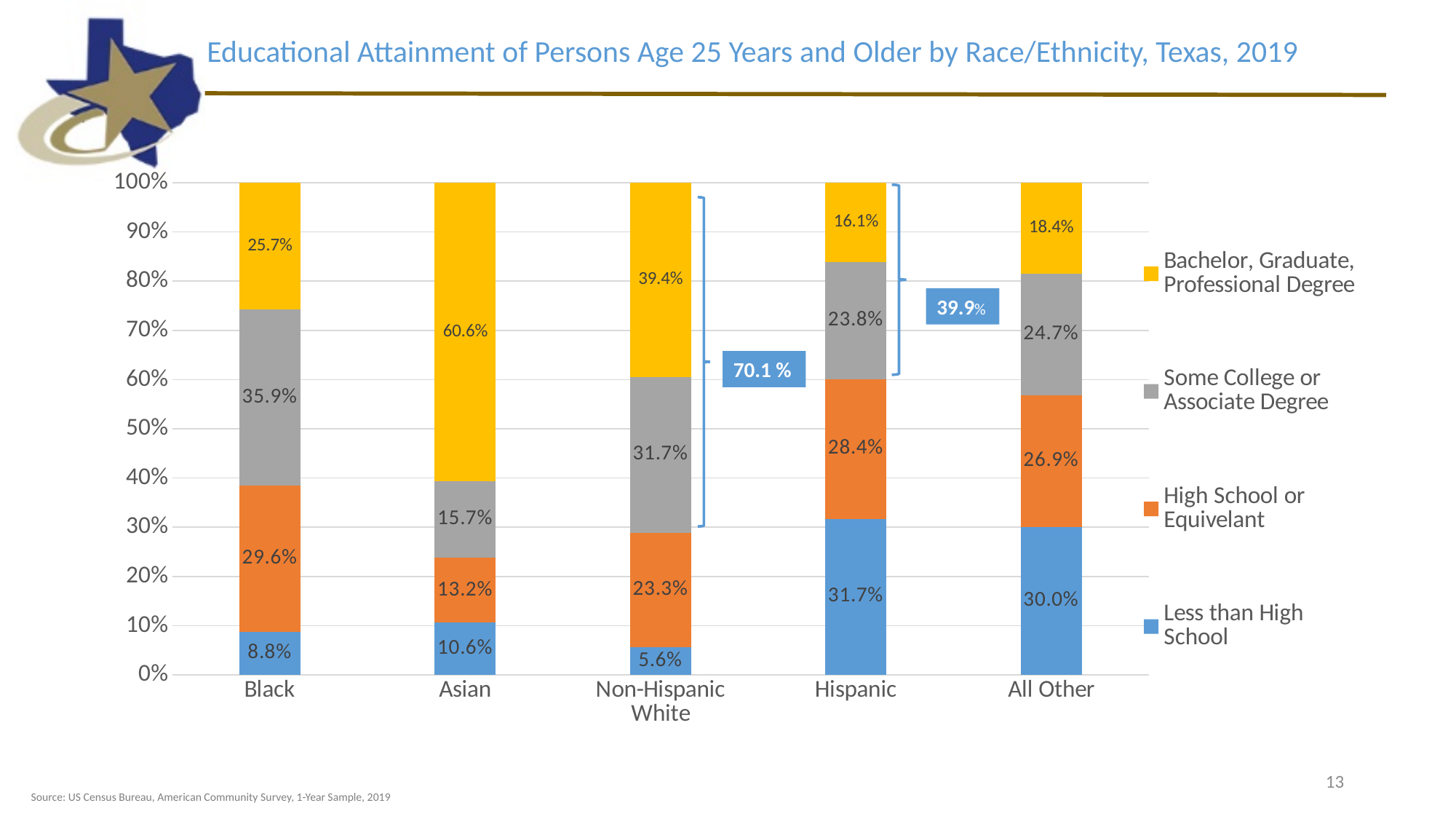
What kind of chart is shown on the slide? Stacked bar chart What is the Less than High School value for Hispanic persons? 31.7% How many series does the legend list? 4 What is the High School or Equivalent value for the Asian category? 13.2% What is the difference in percentage points between the Bachelor, Graduate, Professional Degree share for Asian and for Black persons? 34.9 percentage points Which race/ethnicity category has the lowest Less than High School share? Non-Hispanic White Which colour represents the Less than High School series in the chart? Blue What percentage of Black persons age 25 and older have a Bachelor, Graduate, or Professional Degree? 25.7% Which race/ethnicity category has the highest share with a Bachelor, Graduate, or Professional Degree? Asian How many race/ethnicity categories are shown on the x axis? 5 What is the combined share of Some College or Associate Degree and Bachelor, Graduate, Professional Degree for Non-Hispanic White persons? 70.1% Which is larger: the Some College or Associate Degree share for Black persons or for Hispanic persons? Black